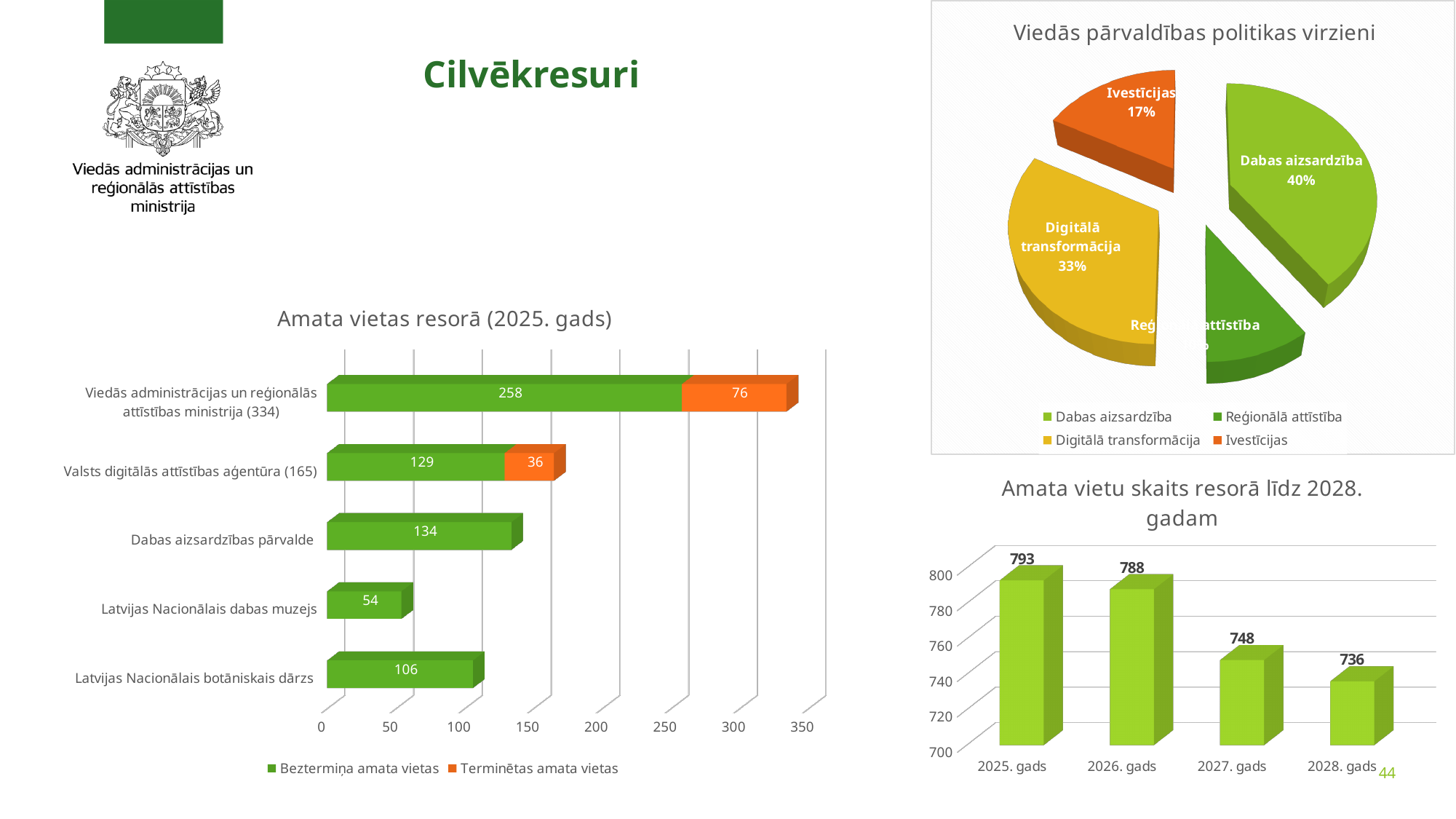
In the chart 'Viedās pārvaldības politikas virzieni', which slice is larger: Digitālā transformācija or Ivestīcijas? Digitālā transformācija In the chart 'Amata vietu skaits resorā līdz 2028. gadam', what is the value for 2027. gads? 748 What kind of chart is 'Viedās pārvaldības politikas virzieni'? pie chart In the chart 'Amata vietas resorā (2025. gads)', which category has the lowest value of Beztermiņa amata vietas? Latvijas Nacionālais dabas muzejs In the chart 'Amata vietu skaits resorā līdz 2028. gadam', do the values rise or fall from 2025. gads to 2028. gads? fall In the chart 'Viedās pārvaldības politikas virzieni', what share does Dabas aizsardzība have? 40% In the chart 'Amata vietas resorā (2025. gads)', what is the value of Beztermiņa amata vietas for Dabas aizsardzības pārvalde? 134 In the chart 'Amata vietas resorā (2025. gads)', what is the difference between the Beztermiņa amata vietas values for Latvijas Nacionālais botāniskais dārzs and Latvijas Nacionālais dabas muzejs? 52 In the chart 'Amata vietas resorā (2025. gads)', what is the total of the stacked bar for Viedās administrācijas un reģionālās attīstības ministrija? 334 In the chart 'Amata vietas resorā (2025. gads)', how many categories are shown? 5 In the chart 'Amata vietas resorā (2025. gads)', what is the value of Terminētas amata vietas for Valsts digitālās attīstības aģentūra? 36 In the chart 'Amata vietas resorā (2025. gads)', how many series does the legend list? 2